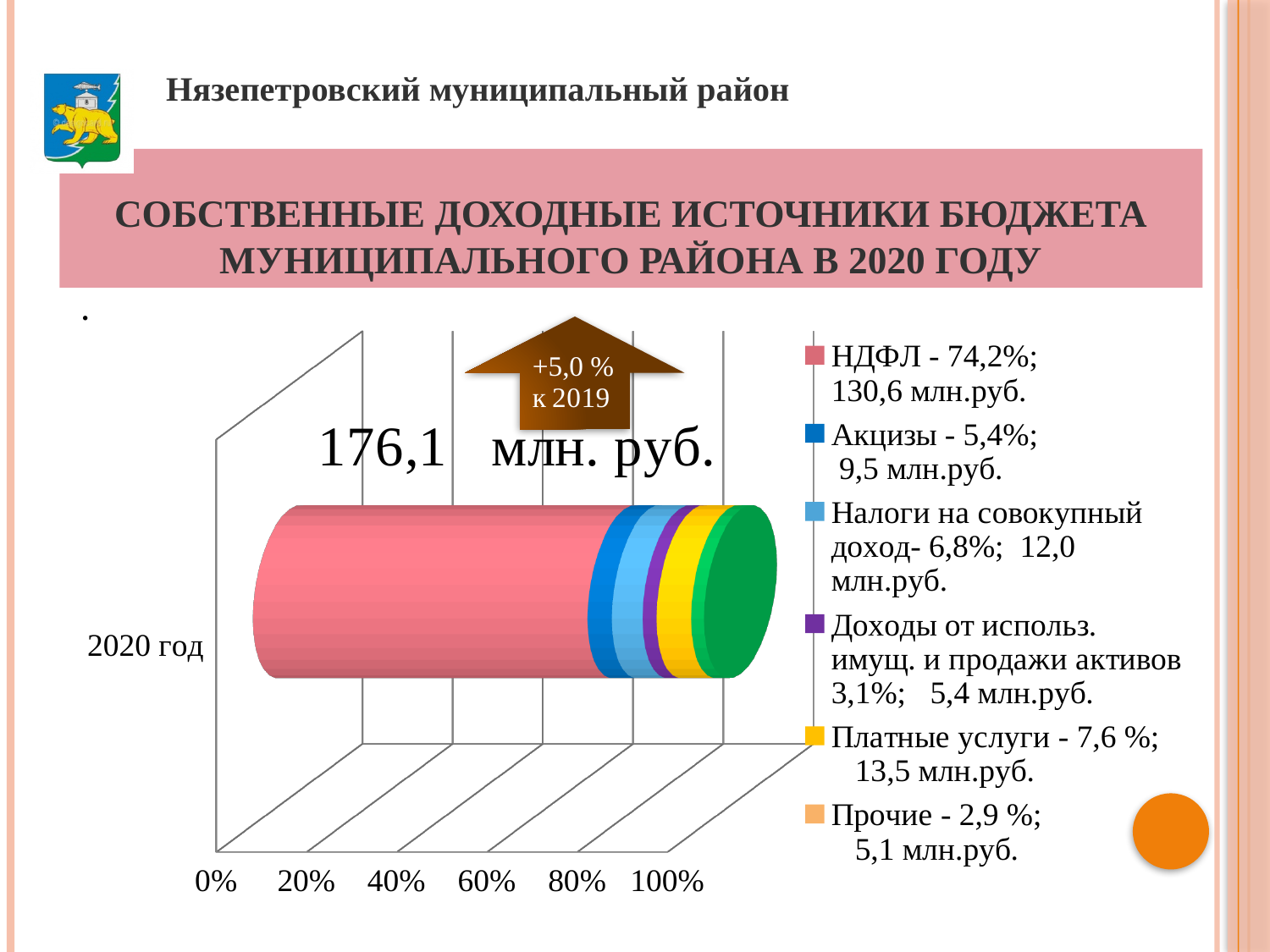
How many series does the chart legend list? 6 Which revenue source has the largest share in the 2020 bar? НДФЛ What total amount in млн. руб. is printed above the 2020 bar? 176,1 млн. руб. What share of the budget's own revenue sources does НДФЛ account for, according to the legend? 74,2% What is the amount in млн.руб. for Акцизы shown in the legend? 9,5 млн.руб. What change relative to 2019 is shown in the arrow above the bar? +5,0 % к 2019 Which is larger: the share of Платные услуги or the share of Акцизы? Платные услуги Which revenue source has the smallest share in the 2020 bar? Прочие What is the difference in млн.руб. between Платные услуги (13,5) and Прочие (5,1)? 8,4 млн.руб. What percentage is given for Платные услуги in the legend? 7,6 % What is the amount for Налоги на совокупный доход shown in the legend? 12,0 млн.руб. What kind of chart is shown on the slide? bar chart